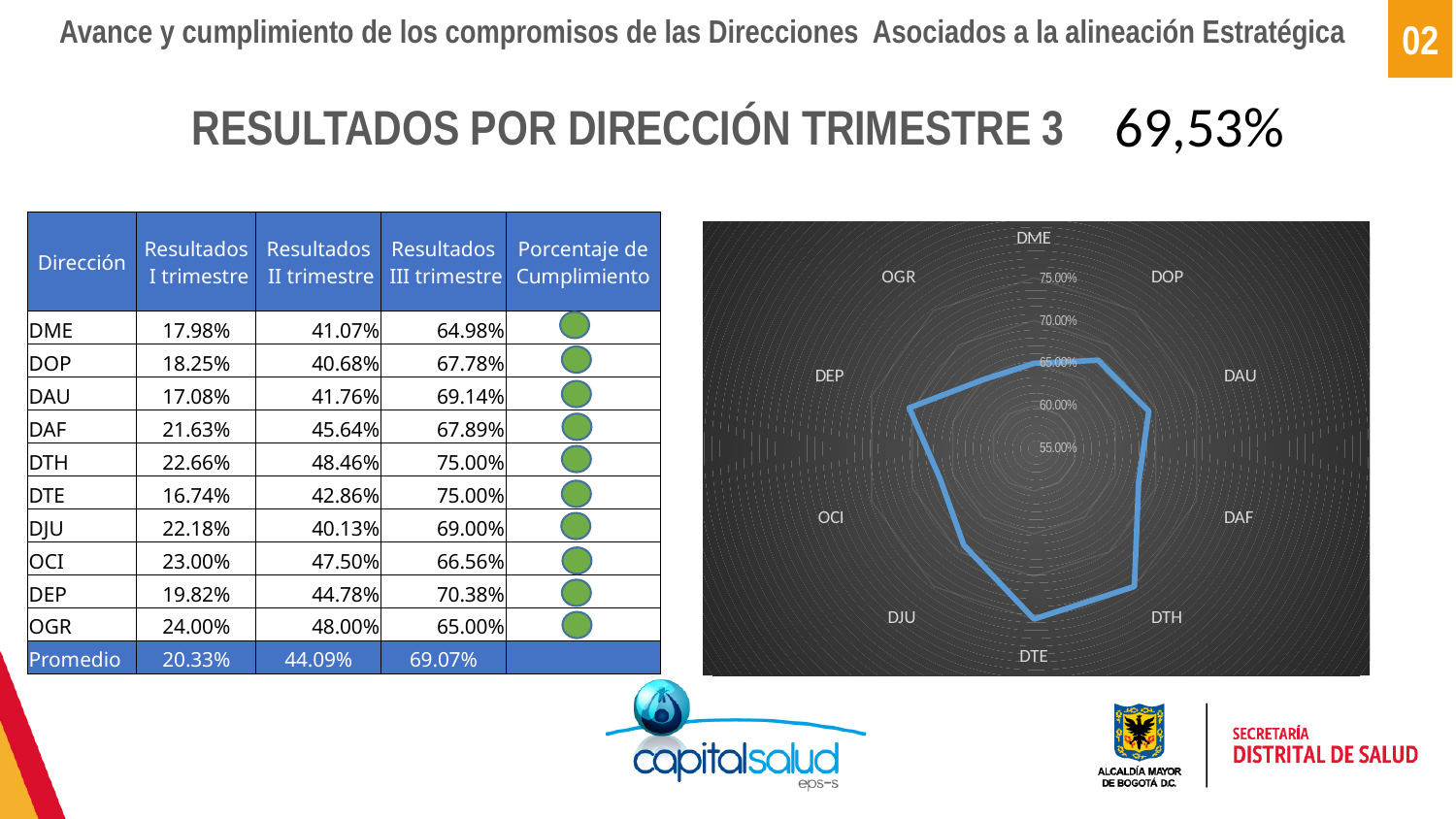
On the radar chart, is the value for DTH greater or less than 70.00%? greater What kind of chart is shown on the right side of the slide? radar chart On the radar chart, is the value for OCI greater or less than 60.00%? greater On the radar chart, which has the larger value, DTH or DME? DTH How many categories (direcciones) are plotted on the radar chart? 10 On the radar chart, is the value for DOP greater or less than 65.00%? greater According to the table on the slide, what III trimestre value is plotted for DTH on the radar chart? 75.00% What is the innermost axis tick label shown on the radar chart? 55.00% What is the outermost axis tick label shown on the radar chart? 75.00%